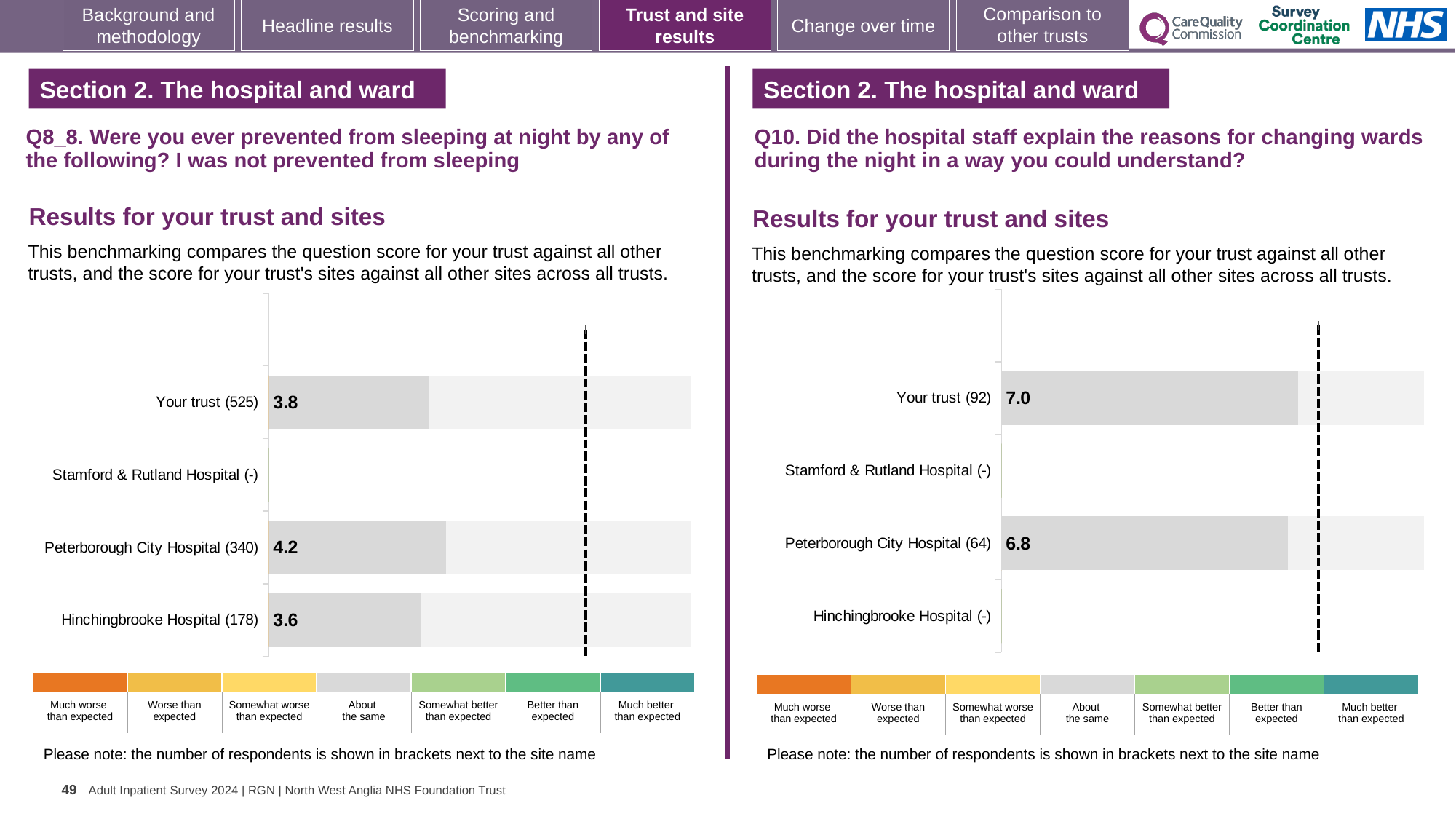
On the Q8_8 chart (left), what is the score for Peterborough City Hospital? 4.2 What kind of chart is used on the Q10 chart (right)? Bar chart On the Q8_8 chart (left), what is the difference between the scores for Peterborough City Hospital and Hinchingbrooke Hospital? 0.6 On the Q8_8 chart (left), what is the score for Your trust? 3.8 On the Q8_8 chart (left), how many respondents are shown for Your trust? 525 On the Q8_8 chart (left), which site has the highest score? Peterborough City Hospital On the Q8_8 chart (left), what is the score for Hinchingbrooke Hospital? 3.6 On the Q10 chart (right), which is larger, the score for Your trust or for Peterborough City Hospital? Your trust On the Q10 chart (right), what is the score for Your trust? 7.0 On the Q10 chart (right), what is the difference between the scores for Your trust and Peterborough City Hospital? 0.2 On the Q10 chart (right), what is the score for Peterborough City Hospital? 6.8 On the Q8_8 chart (left), which site has the lowest score? Hinchingbrooke Hospital